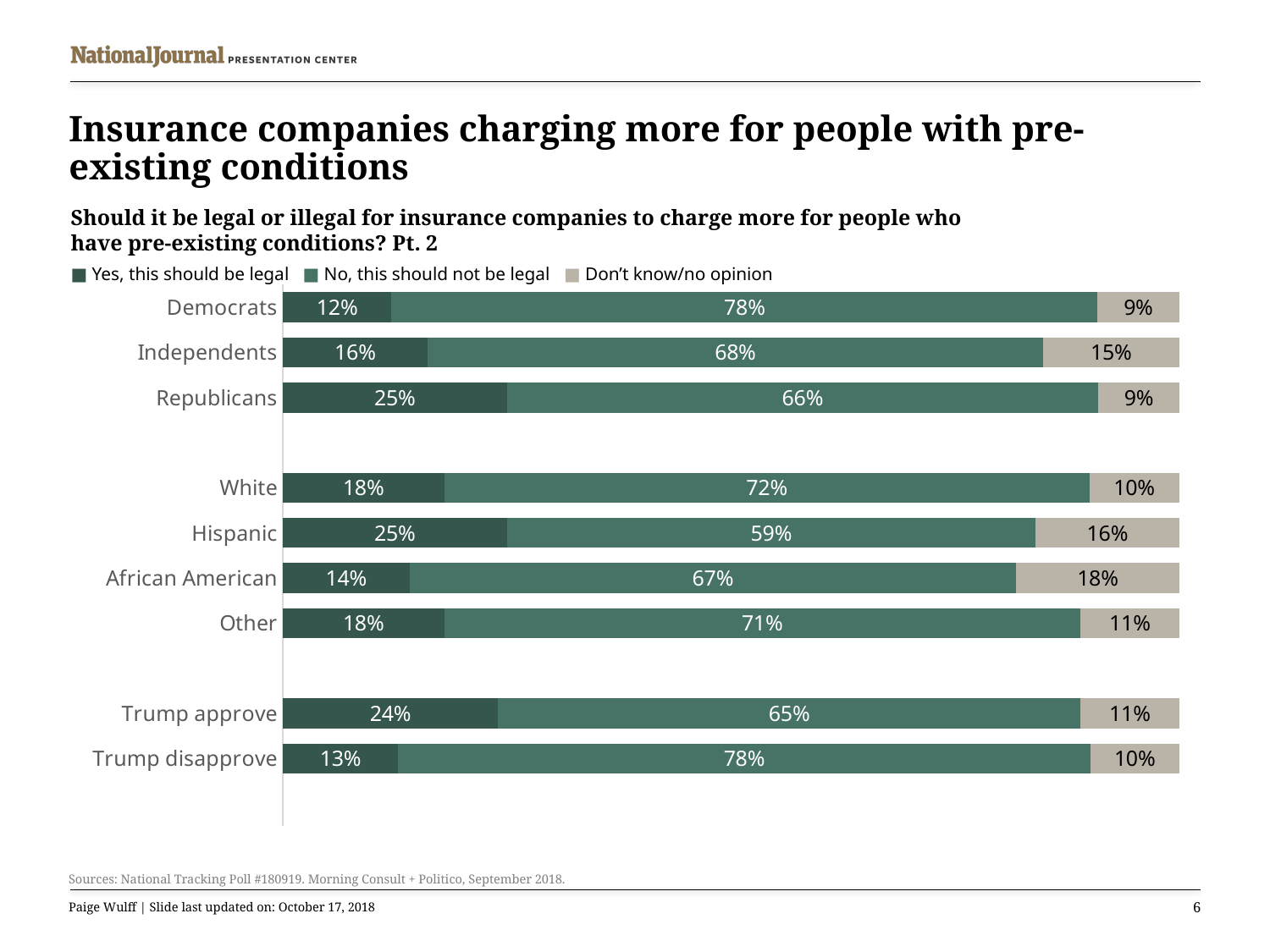
Which group has the lowest share saying 'Yes, this should be legal'? Democrats What percentage of Hispanic respondents say this should be legal? 25% What percentage of Democrats say it should not be legal for insurance companies to charge more for people with pre-existing conditions? 78% How many groups are shown in the chart? 9 What kind of chart is shown on the slide? Stacked bar chart What is the total of the three labeled values in the Independents bar? 99% Which group has a larger 'Yes, this should be legal' share: Trump approve or Trump disapprove? Trump approve How many series does the legend list? 3 Which group has the highest 'Don't know/no opinion' share? African American Which group has the lowest share saying 'No, this should not be legal'? Hispanic What is the 'Don't know/no opinion' value for Independents? 15% How many percentage points higher is the 'Yes, this should be legal' share for Republicans than for Democrats? 13 percentage points